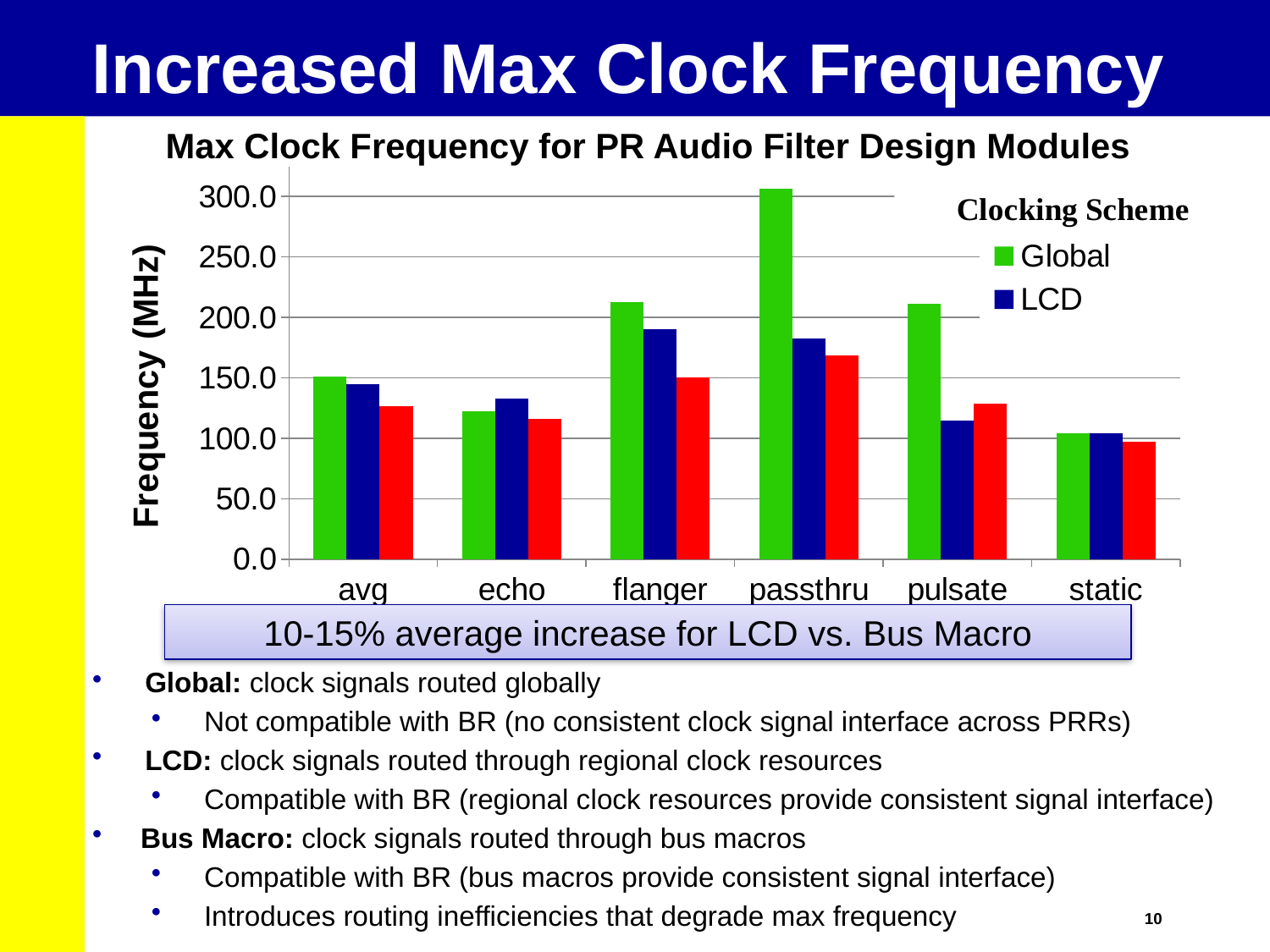
Is the LCD value for passthru greater or less than 200.0? less What is the title of the chart? Max Clock Frequency for PR Audio Filter Design Modules How many categories are shown on the x axis of the chart? 6 What kind of chart is shown on the slide? bar chart Is the Global value for flanger greater or less than 200.0? greater How many series does the chart's legend list? 2 Is the Global value for echo greater or less than 150.0? less For which category is the Global series highest? passthru What is the label of the y axis of the chart? Frequency (MHz) For passthru, which is larger: the Global value or the LCD value? Global For echo, which is larger: the Global value or the LCD value? LCD For which category is the Global series lowest? static